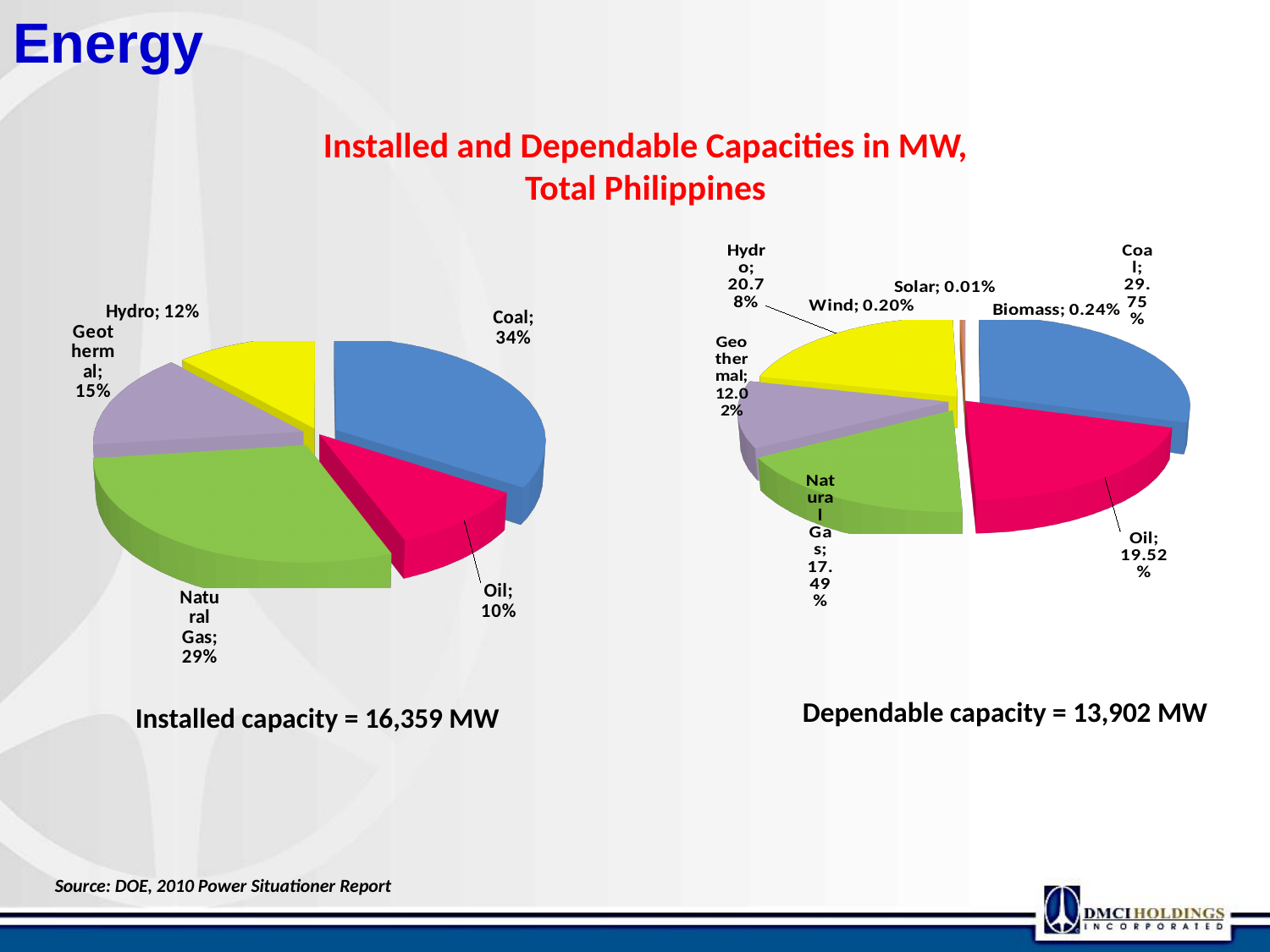
On the right pie chart (Dependable capacity), how many sources are shown? 8 On the left pie chart (Installed capacity), what share does Coal have? 34% What is the total installed capacity stated below the left chart? 16,359 MW On the left pie chart (Installed capacity), how many percentage points larger is Coal's share than Hydro's share? 22 On the right pie chart (Dependable capacity), which source has the largest share? Coal What type of chart is used on this slide? Pie chart On the left pie chart (Installed capacity), how many sources are shown? 5 On the right pie chart (Dependable capacity), what share does Solar have? 0.01% On the right pie chart (Dependable capacity), which is larger, the share of Oil or the share of Natural Gas? Oil On the left pie chart (Installed capacity), which source has the smallest share? Oil On the right pie chart (Dependable capacity), what share does Hydro have? 20.78% On the left pie chart (Installed capacity), what share does Natural Gas have? 29%